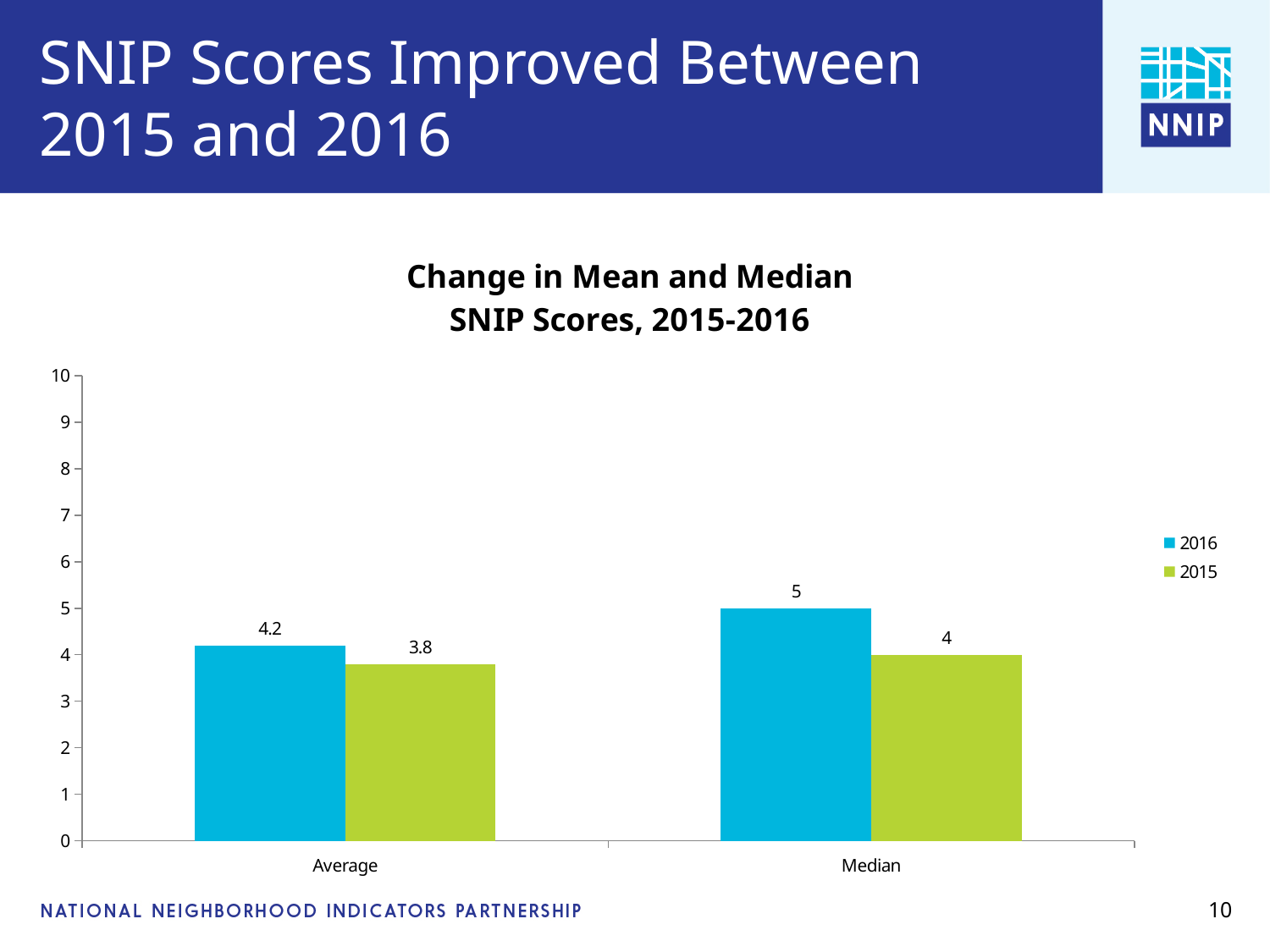
How many series does the legend list? 2 What is the difference between the 2016 and 2015 values for Average? 0.4 What is the 2015 value for Average? 3.8 What is the 2016 value for Median? 5 How many categories are shown on the x axis? 2 What is the difference between the 2016 and 2015 values for Median? 1 Which category has the lowest 2015 value? Average Which category has the highest 2016 value? Median Which is larger, the 2016 value for Median or the 2016 value for Average? 2016 value for Median What is the 2015 value for Median? 4 What kind of chart is shown on the slide? Bar chart What is the 2016 value for Average? 4.2